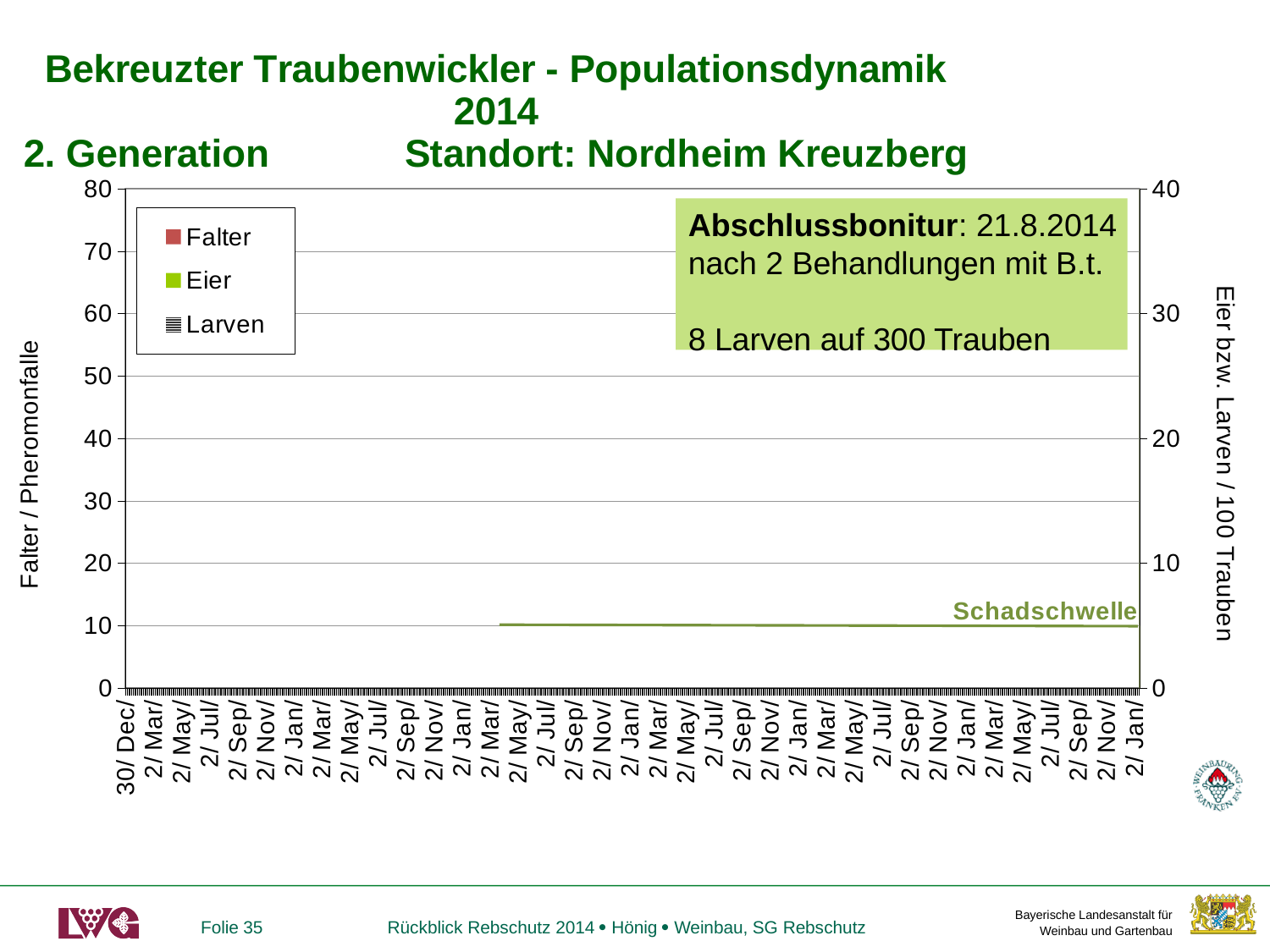
According to the text box on the chart, how many Larven were found auf 300 Trauben at the Abschlussbonitur? 8 What is the highest value shown on the left vertical axis? 80 How many series does the chart legend list? 3 What is the label on the horizontal line drawn across the chart near the bottom? Schadschwelle On the left axis, is the Schadschwelle line greater or less than 20? less What are the three series named in the chart legend? Falter, Eier, Larven On the right axis, is the Schadschwelle line greater or less than 10? less What is the date of the Abschlussbonitur given on the chart? 21.8.2014 What is the highest value shown on the right vertical axis? 40